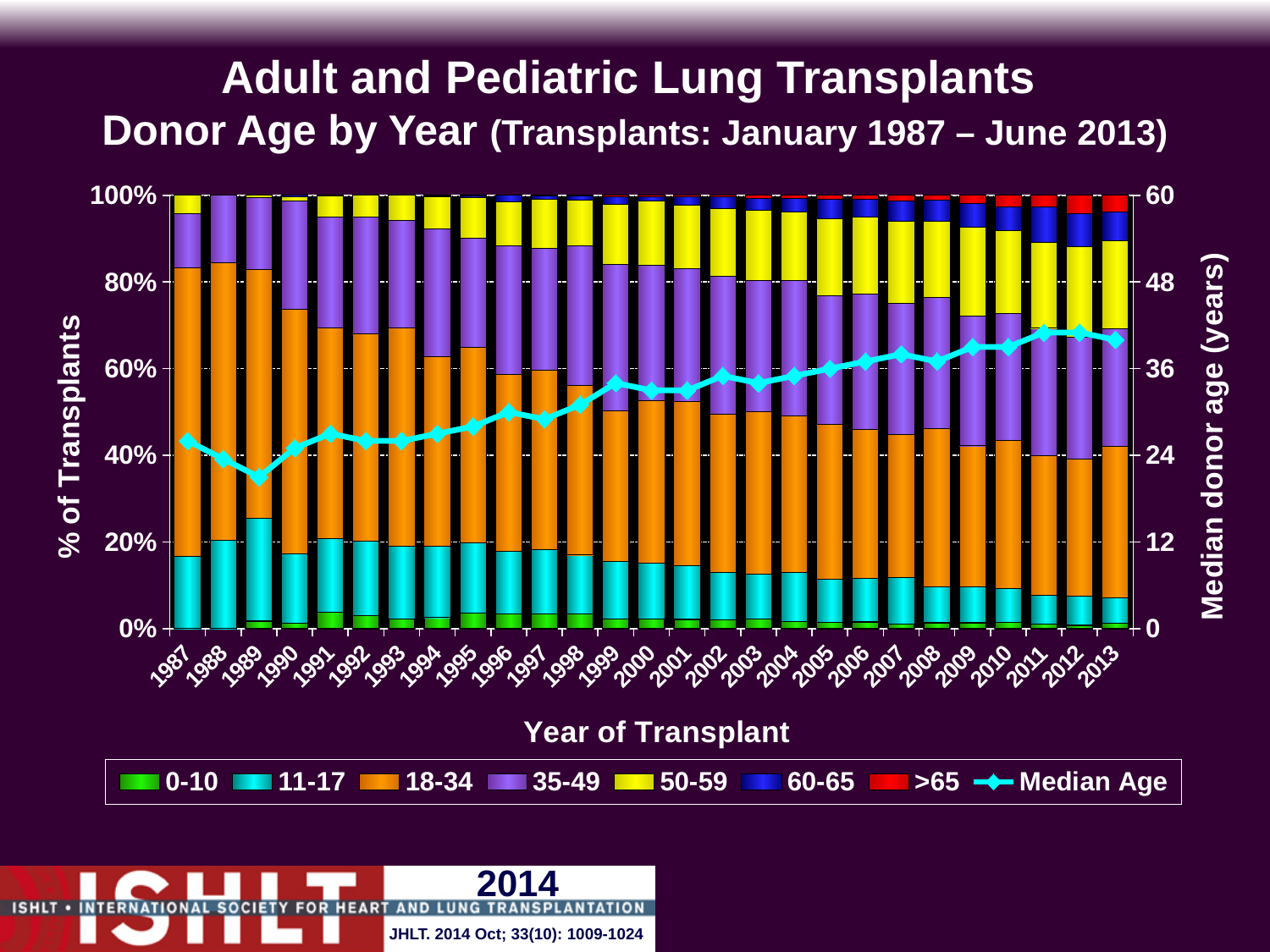
Is the median donor age in 1996 greater or less than 36? less What is the label of the right-hand vertical axis? Median donor age (years) What is the label of the x axis? Year of Transplant Is the median donor age in 1989 greater or less than 24? less How many years are shown along the x axis of the chart? 27 Does the median donor age generally rise or fall from 1987 to 2013? rise What kind of chart is shown on the slide? Stacked bar chart with a line Is the median donor age in 2013 greater or less than 36? greater Which year has the higher median donor age, 1989 or 2011? 2011 How many entries does the chart's legend list? 8 Which year has the lowest median donor age? 1989